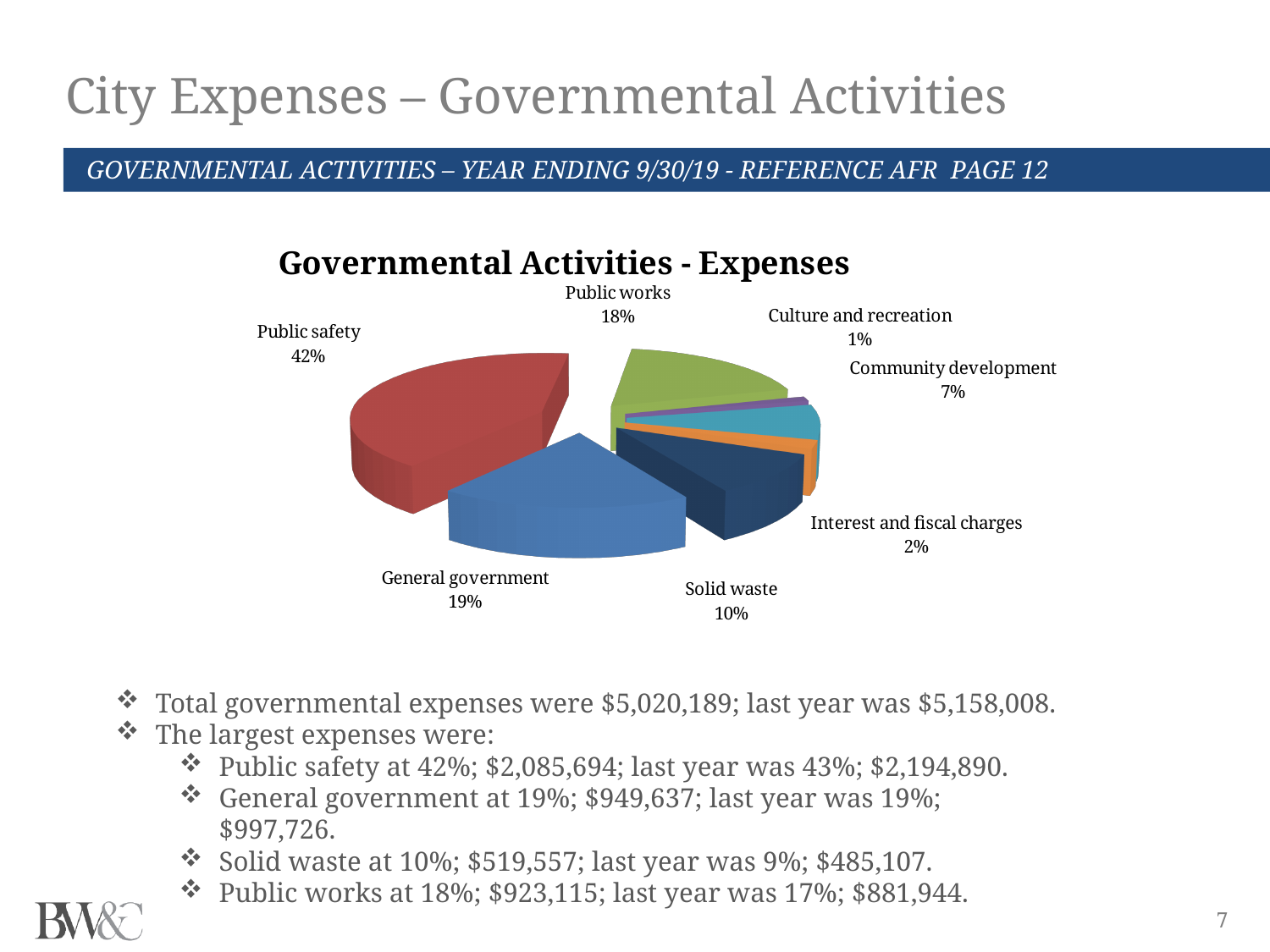
Which is larger, the share for Solid waste or the share for Community development? Solid waste What is the value shown for General government? 19% Which category has the smallest share of the pie? Culture and recreation How many categories are shown in the pie chart? 7 What is the difference in percentage points between Public safety and General government? 23 What share of the pie does Public safety represent? 42% What percentage is shown for Public works? 18% What is the value for Solid waste? 10% What kind of chart is shown on the slide? Pie chart What is the title of the chart? Governmental Activities - Expenses Which category has the largest share of the pie? Public safety What percentage is shown for Community development? 7%